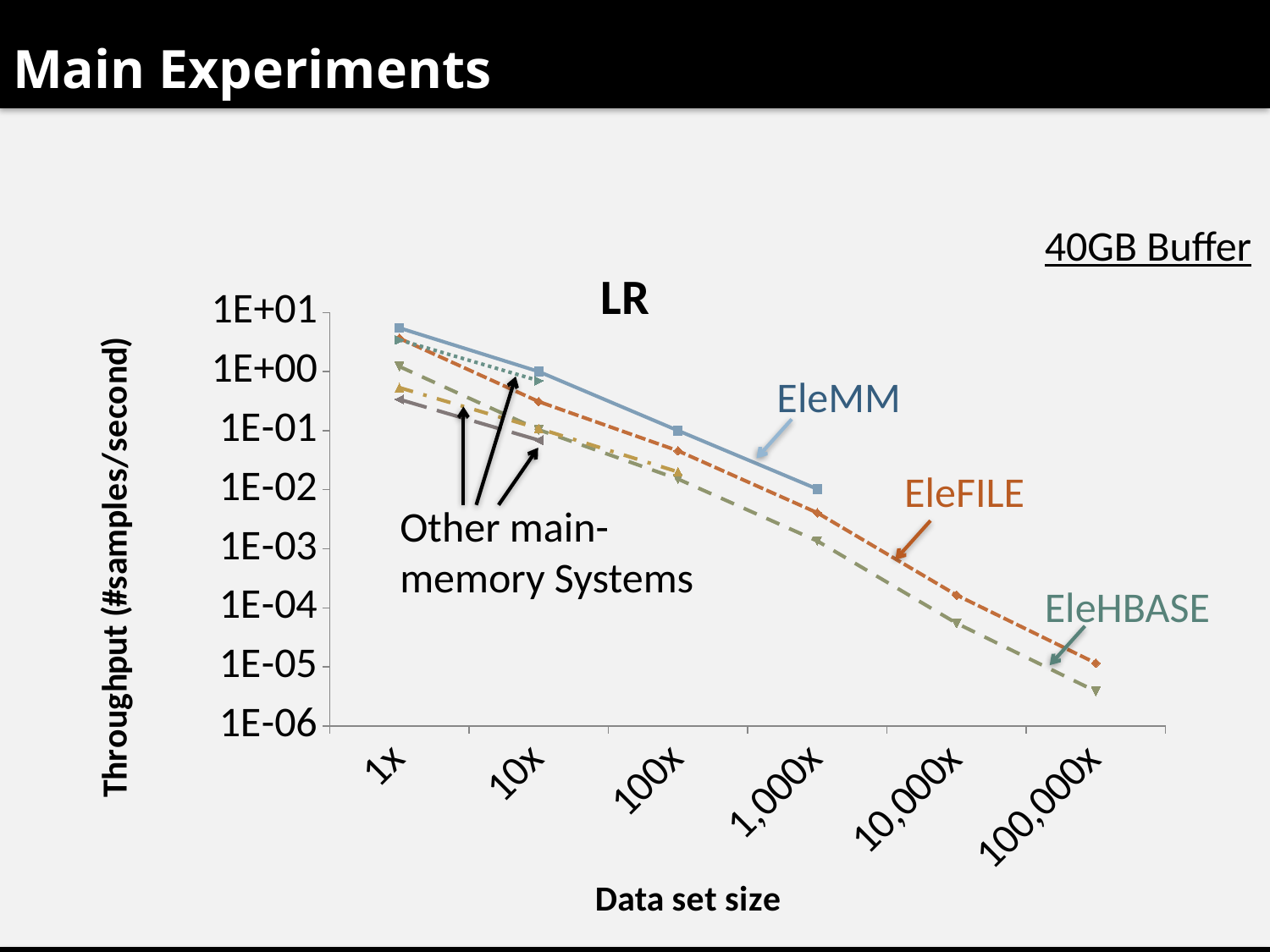
What kind of chart is shown on the slide? line chart Is the throughput of EleFILE at 1,000x greater or less than 1E-03? greater At a data set size of 100,000x, which has the higher throughput, EleFILE or EleHBASE? EleFILE How many data set size categories are shown on the x axis? 6 Does throughput rise or fall as the data set size increases along the x axis? fall What is the throughput of EleMM at a data set size of 100x? 1E-01 What is the title of the chart? LR Which system has the highest throughput at a data set size of 1x? EleMM What is the throughput of EleMM at a data set size of 1,000x? 1E-02 What is the throughput of EleMM at a data set size of 10x? 1E+00 Is the throughput of EleHBASE at 10,000x greater or less than 1E-03? less What buffer size is noted on the slide for this experiment? 40GB Buffer